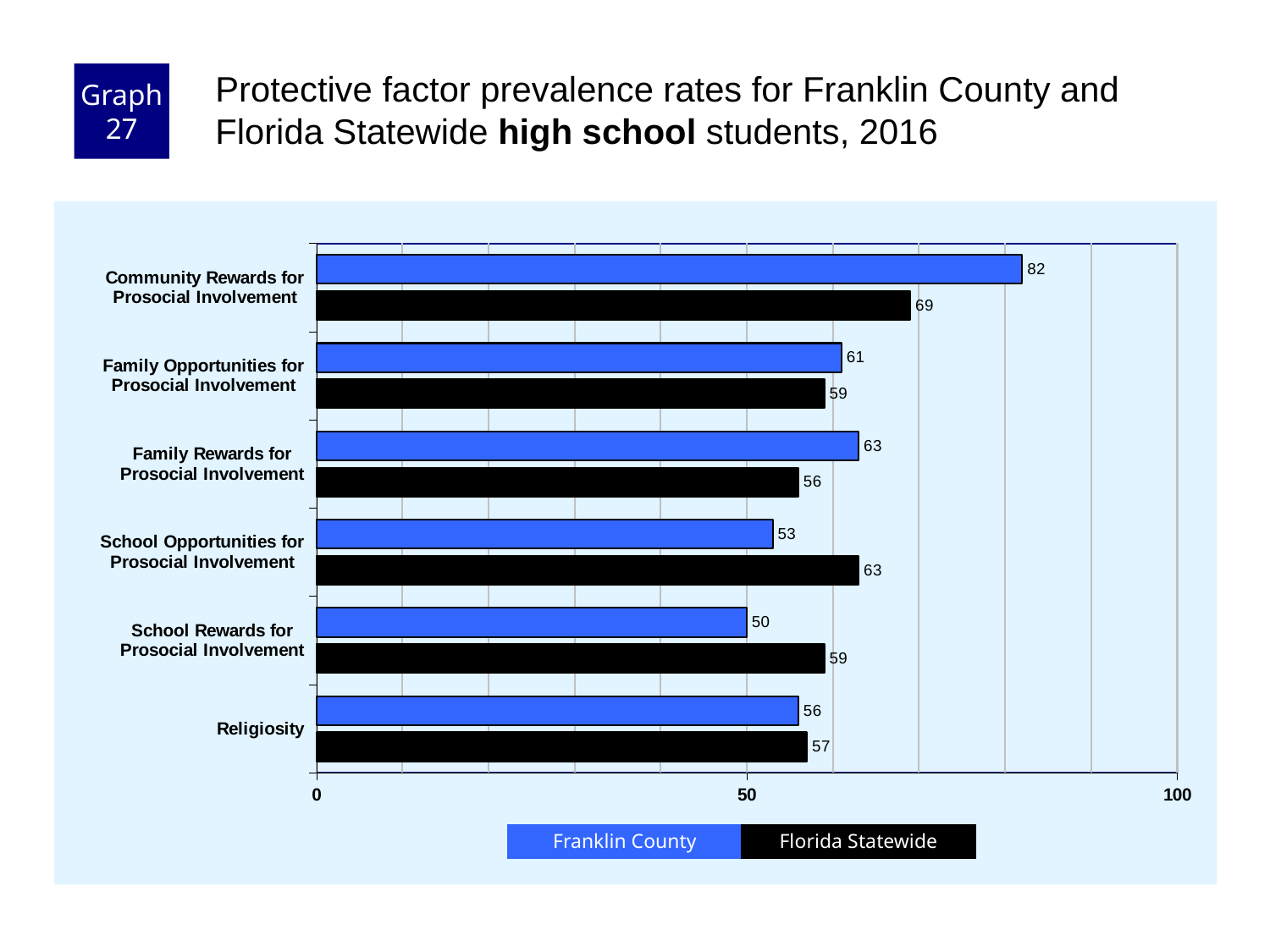
Is the Franklin County value for Community Rewards for Prosocial Involvement greater or less than 50? greater For Family Rewards for Prosocial Involvement, which is larger: the Franklin County value or the Florida Statewide value? Franklin County What is the Florida Statewide value for Religiosity? 57 What is the Florida Statewide value for School Opportunities for Prosocial Involvement? 63 How many protective factor categories are shown on the chart? 6 What is the difference between the Florida Statewide and Franklin County values for School Rewards for Prosocial Involvement? 9 What is the difference between the Franklin County and Florida Statewide values for Community Rewards for Prosocial Involvement? 13 How many series does the legend list? 2 Which category has the highest Franklin County value? Community Rewards for Prosocial Involvement Which category has the lowest Franklin County value? School Rewards for Prosocial Involvement What is the Franklin County value for Community Rewards for Prosocial Involvement? 82 What kind of chart is shown on the slide? bar chart